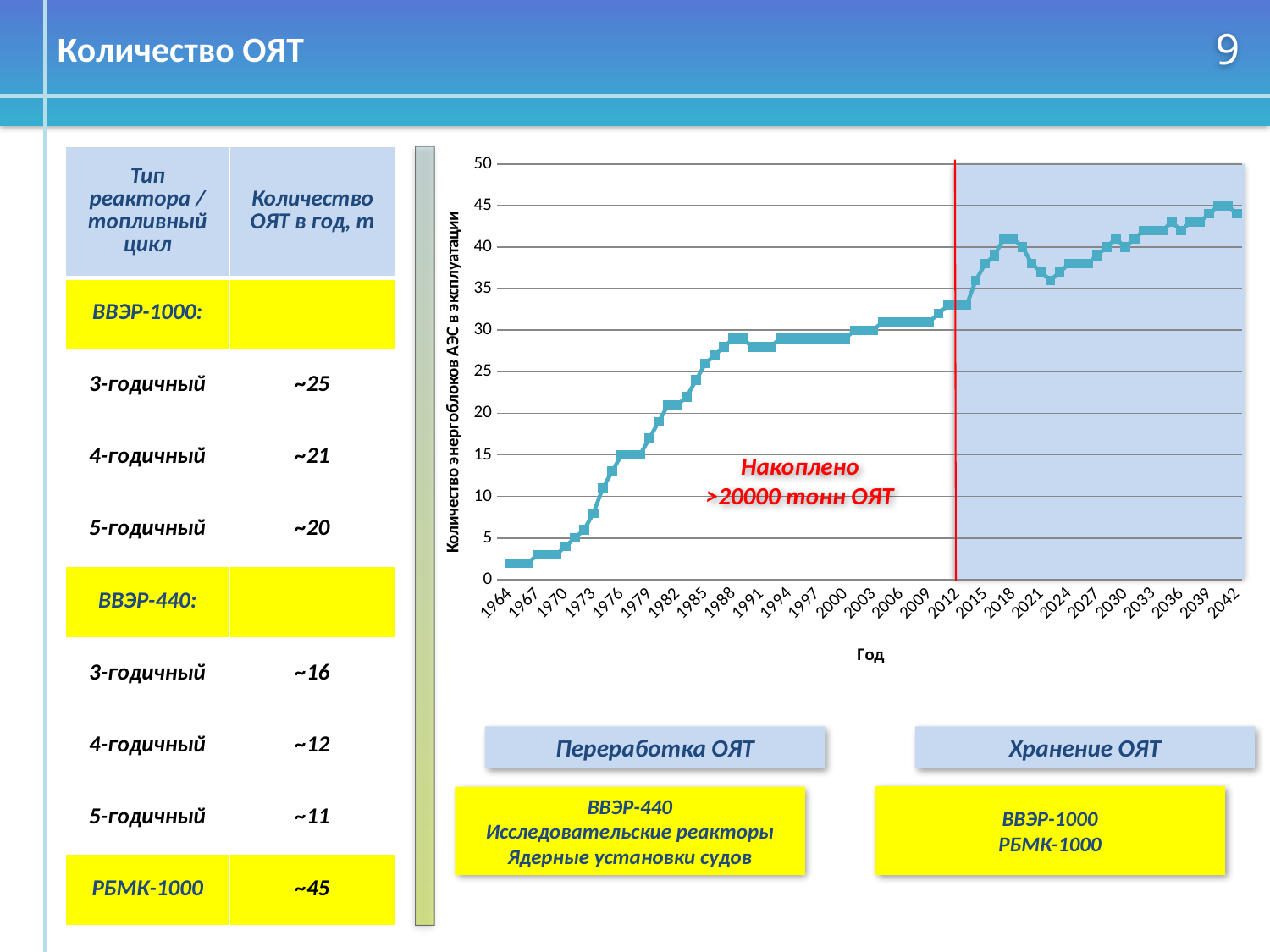
Which year has the larger value, 1964 or 2042? 2042 Overall, do the values rise or fall from 1964 to 2042? rise Is the value for 1976 greater or less than 20? less Is the value for 1964 greater or less than 5? less Is the value for 2042 greater or less than 40? greater What is the title of the vertical axis of the chart? Количество энергоблоков АЭС в эксплуатации Which year has the larger value, 2018 or 2021? 2018 What kind of chart is shown on the slide? line chart What is the title of the horizontal axis of the chart? Год